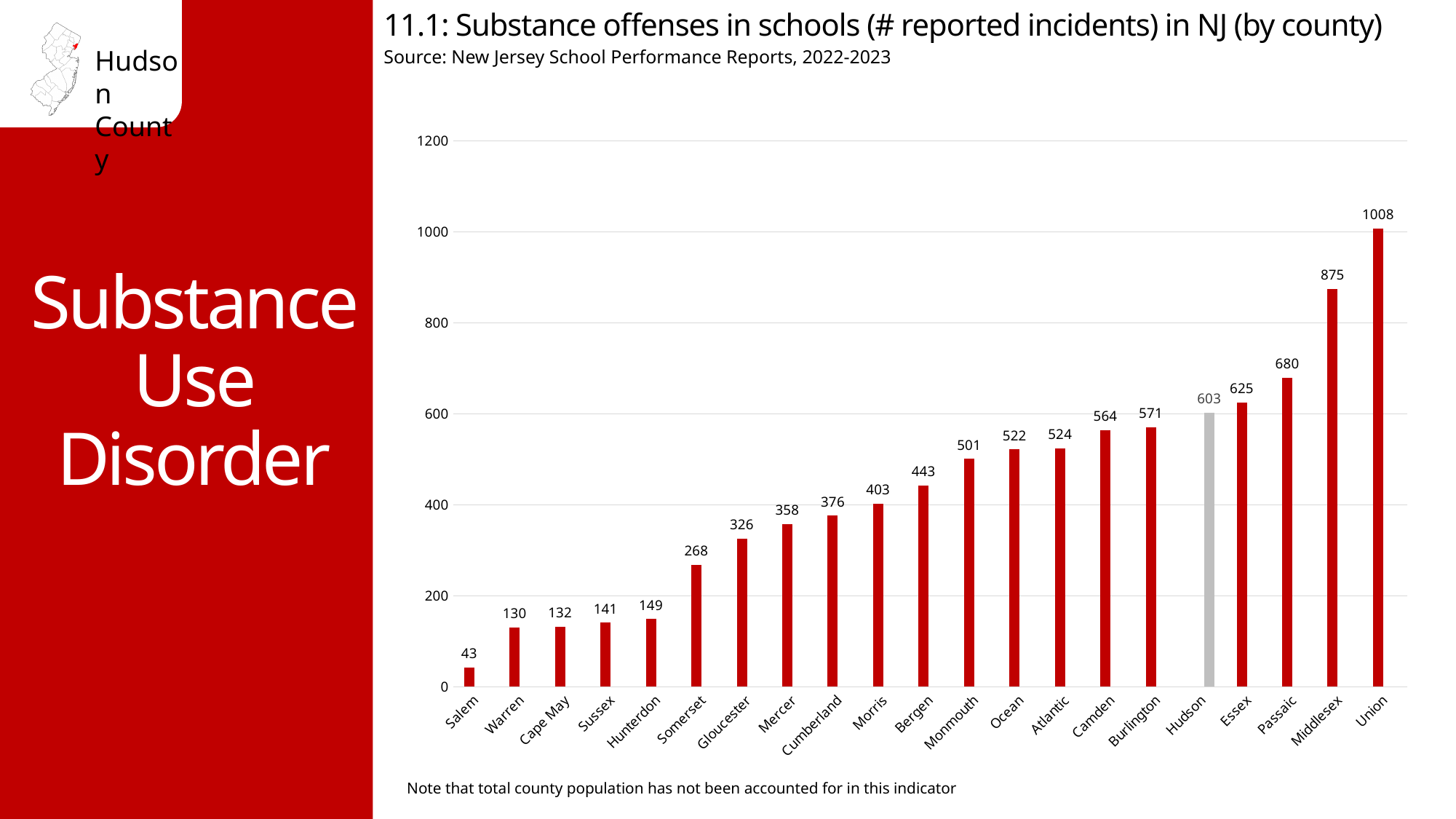
What is the value shown for Somerset? 268 Is the value for Passaic greater or less than 600? greater Which county has the lowest number of reported incidents? Salem What is the difference between the values for Essex and Burlington? 54 How many counties are shown on the x axis? 21 What is the number of reported substance offense incidents in schools for Hudson County? 603 Which county has the highest number of reported incidents? Union What kind of chart is shown on the slide? Bar chart What is the value shown for Middlesex? 875 Which bar is shown in a different colour (grey) from the others? Hudson Which has a higher value, Bergen or Monmouth? Monmouth What is the difference between the values for Union and Hudson? 405